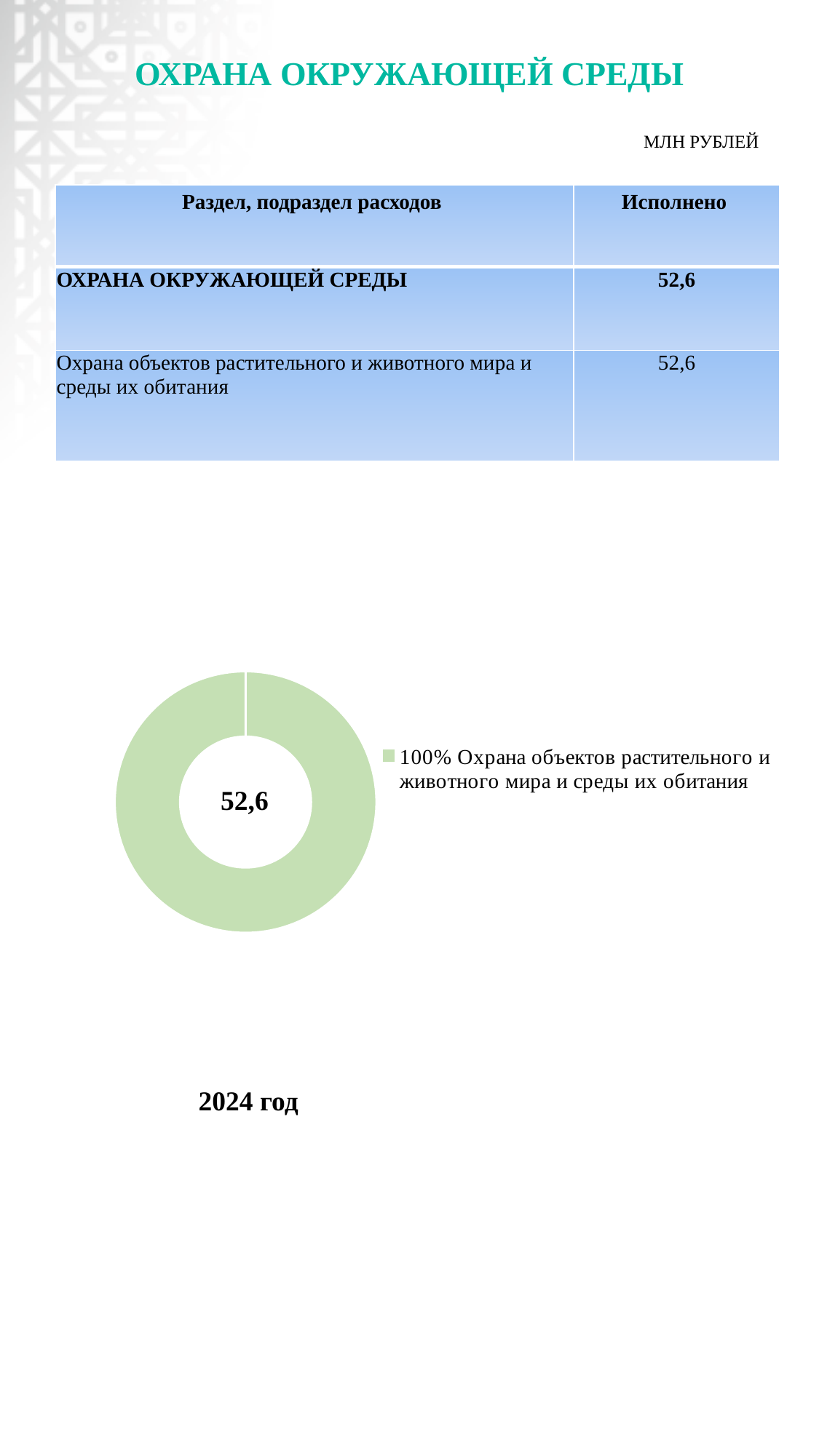
What value is printed in the centre of the doughnut chart? 52,6 How many slices does the doughnut chart have? 1 In what units are the values on the slide given? МЛН РУБЛЕЙ What share of the doughnut chart does "Охрана объектов растительного и животного мира и среды их обитания" take? 100% Which year is labelled below the doughnut chart? 2024 год What colour is the slice of the doughnut chart? Green What is the legend entry of the doughnut chart? 100% Охрана объектов растительного и животного мира и среды их обитания What kind of chart is shown on the slide? Doughnut (pie) chart How many entries does the legend of the doughnut chart list? 1